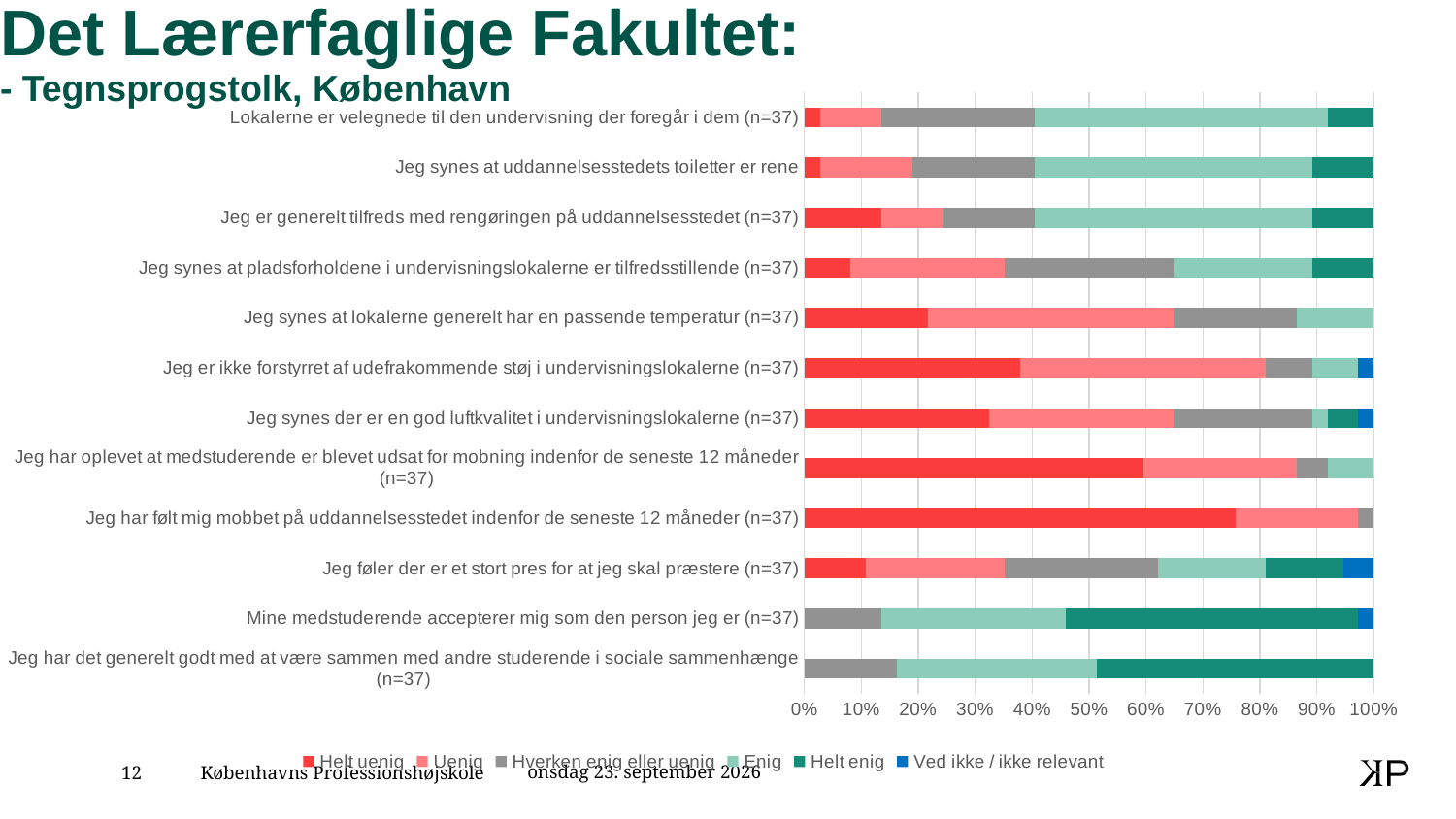
Is the 'Helt uenig' share for 'Jeg synes at lokalerne generelt har en passende temperatur' greater or less than 30%? less Is the 'Enig' share for 'Lokalerne er velegnede til den undervisning der foregår i dem' greater or less than 40%? greater Is the 'Helt uenig' share for 'Jeg har oplevet at medstuderende er blevet udsat for mobning indenfor de seneste 12 måneder' greater or less than 50%? greater Which series is listed first in the legend? Helt uenig Which statement has the largest 'Helt uenig' share? Jeg har følt mig mobbet på uddannelsesstedet indenfor de seneste 12 måneder How many series does the legend list? 6 Which has the larger 'Helt uenig' share: 'Jeg har følt mig mobbet på uddannelsesstedet indenfor de seneste 12 måneder' or 'Jeg føler der er et stort pres for at jeg skal præstere'? Jeg har følt mig mobbet på uddannelsesstedet indenfor de seneste 12 måneder What is the sample size (n) shown for each statement in the chart? 37 How many statements (categories) are plotted in the chart? 12 What kind of chart is shown on the slide? Stacked bar chart